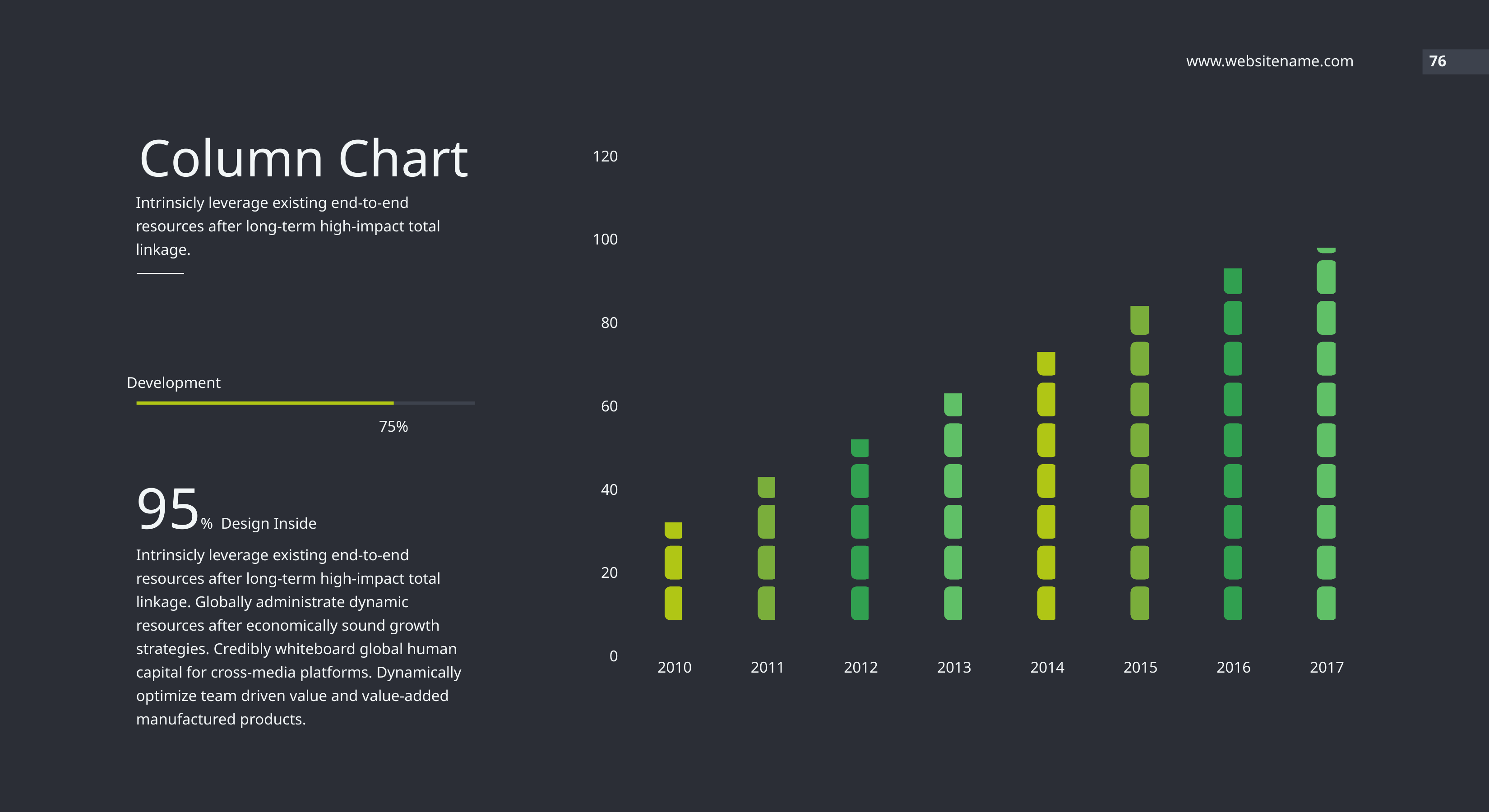
Is the value for 2014 greater or less than 60? greater Which year has the lowest bar in the chart? 2010 Is the value for 2016 greater or less than 80? greater What is the first year shown on the x axis of the chart? 2010 Do the bar values rise or fall from 2010 to 2017? rise Is the value for 2010 greater or less than 40? less Which year has the highest bar in the chart? 2017 What kind of chart is shown on the slide? bar chart Which is larger, the value for 2013 or the value for 2011? 2013 What is the highest tick value shown on the y axis of the chart? 120 How many years are shown on the x axis of the chart? 8